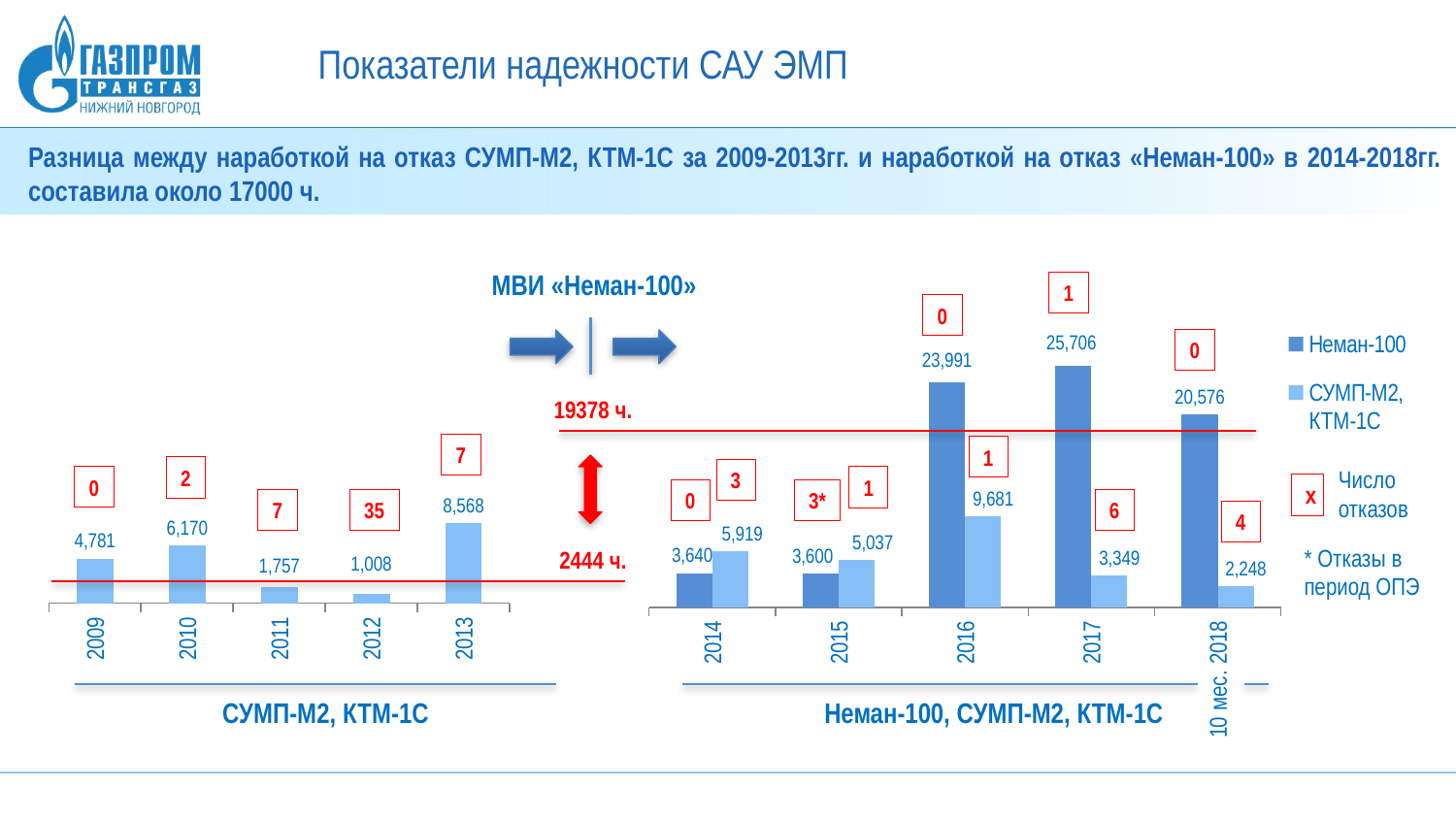
In the left chart (СУМП-М2, КТМ-1С), what is the difference between the values for 2010 and 2009? 1,389 What kind of chart is used on the slide? Bar chart In the right chart (Неман-100, СУМП-М2, КТМ-1С), which year has the highest Неман-100 value? 2017 In the right chart (Неман-100, СУМП-М2, КТМ-1С), which is larger for 2014: the Неман-100 value or the СУМП-М2, КТМ-1С value? СУМП-М2, КТМ-1С In the right chart (Неман-100, СУМП-М2, КТМ-1С), how many failures (число отказов) are shown for СУМП-М2, КТМ-1С in 2017? 6 In the left chart (СУМП-М2, КТМ-1С), which year has the lowest value? 2012 In the left chart (СУМП-М2, КТМ-1С), what is the value for 2013? 8,568 How many series does the legend of the right chart list? 2 In the right chart (Неман-100, СУМП-М2, КТМ-1С), what is the СУМП-М2, КТМ-1С value for 2016? 9,681 In the right chart (Неман-100, СУМП-М2, КТМ-1С), what is the Неман-100 value for 2017? 25,706 In the right chart (Неман-100, СУМП-М2, КТМ-1С), what is the difference between the Неман-100 value and the СУМП-М2, КТМ-1С value for 10 мес. 2018? 18,328 In the left chart (СУМП-М2, КТМ-1С), how many years are shown on the x axis? 5